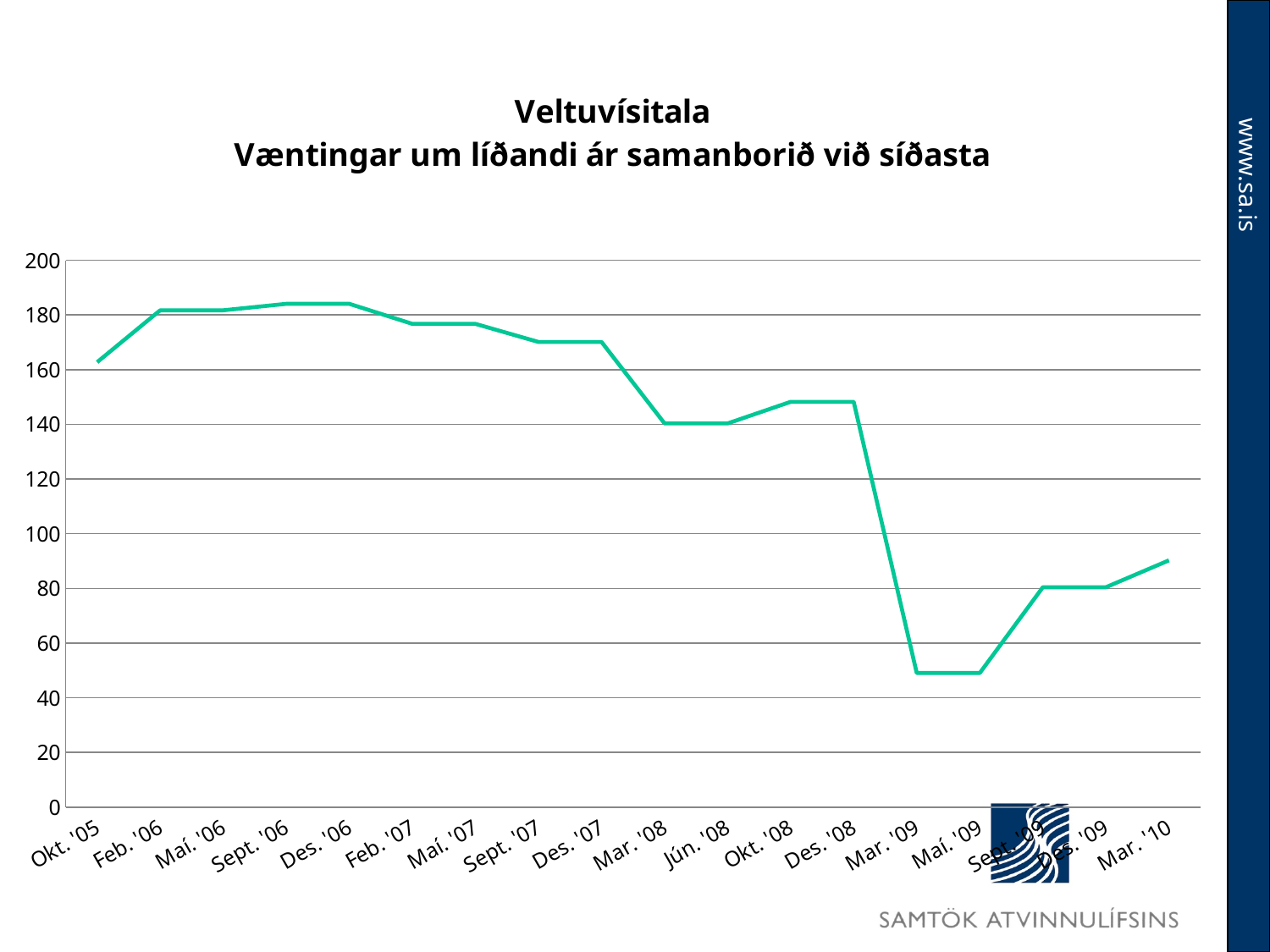
Overall, does the line rise or fall from Okt. '05 to Mar. '10? Fall Is the value for Mar. '10 greater or less than 80? greater Is the value for Sept. '06 greater or less than 180? greater What kind of chart is shown on the slide? Line chart Is the value for Des. '08 greater or less than 140? greater How many data points are plotted along the x axis? 18 What is the first line of the chart title? Veltuvísitala Which has the larger value, Feb. '06 or Mar. '10? Feb. '06 Which has the larger value, Des. '08 or Maí '09? Des. '08